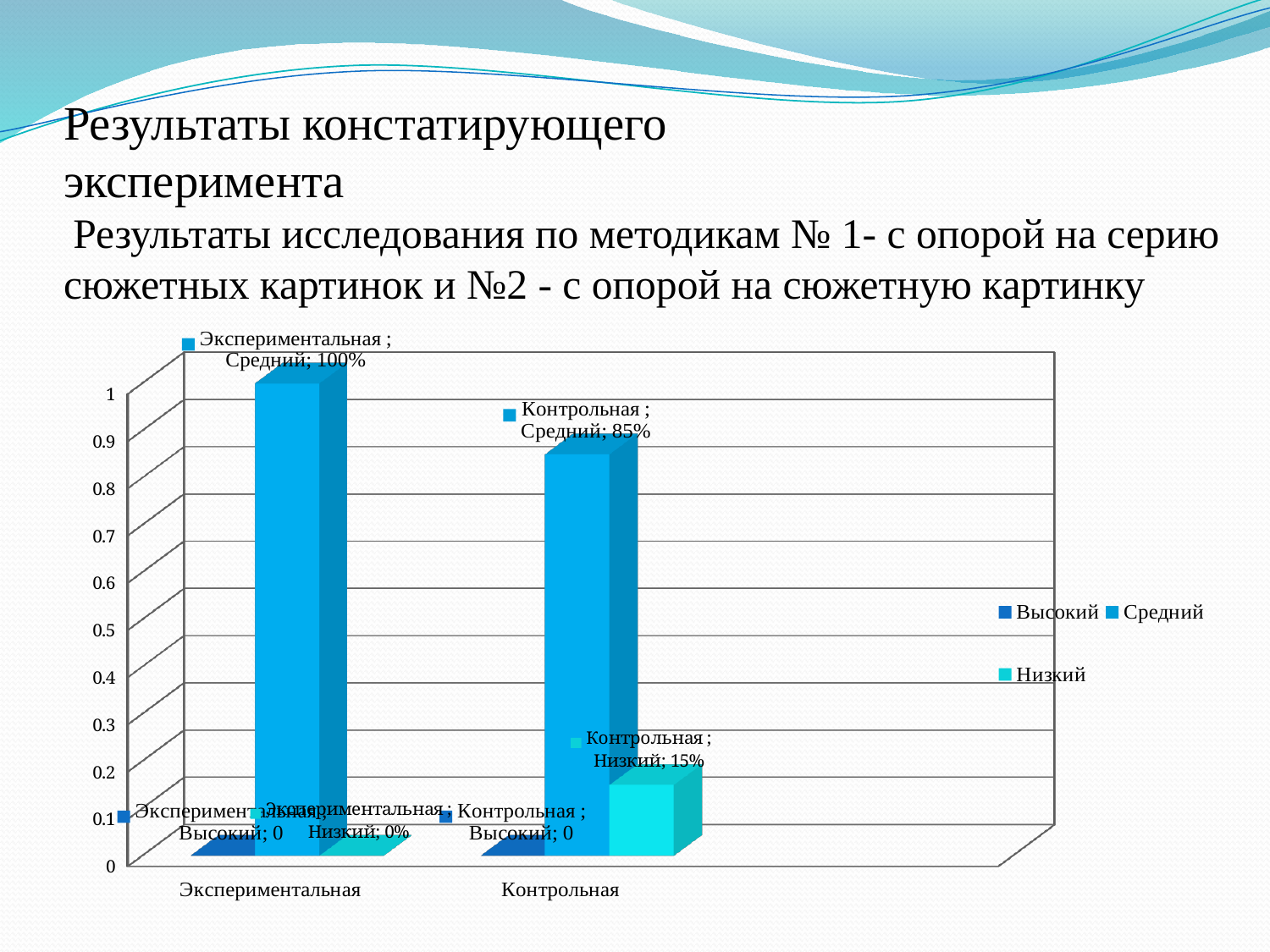
Which group has the higher Средний value, Экспериментальная or Контрольная? Экспериментальная How many series does the chart legend list? 3 How many categories are shown on the x axis of the chart? 2 What is the value of Высокий for the Контрольная group? 0 What is the value of Средний for the Экспериментальная group? 100% What is the value of Низкий for the Экспериментальная group? 0% What type of chart is shown on the slide? bar chart What is the value of Средний for the Контрольная group? 85% Which level has the highest value in the Контрольная group? Средний Which series is shown in the lightest (cyan) colour in the legend? Низкий What is the difference between the Средний values of the Экспериментальная and Контрольная groups? 15% What is the value of Низкий for the Контрольная group? 15%